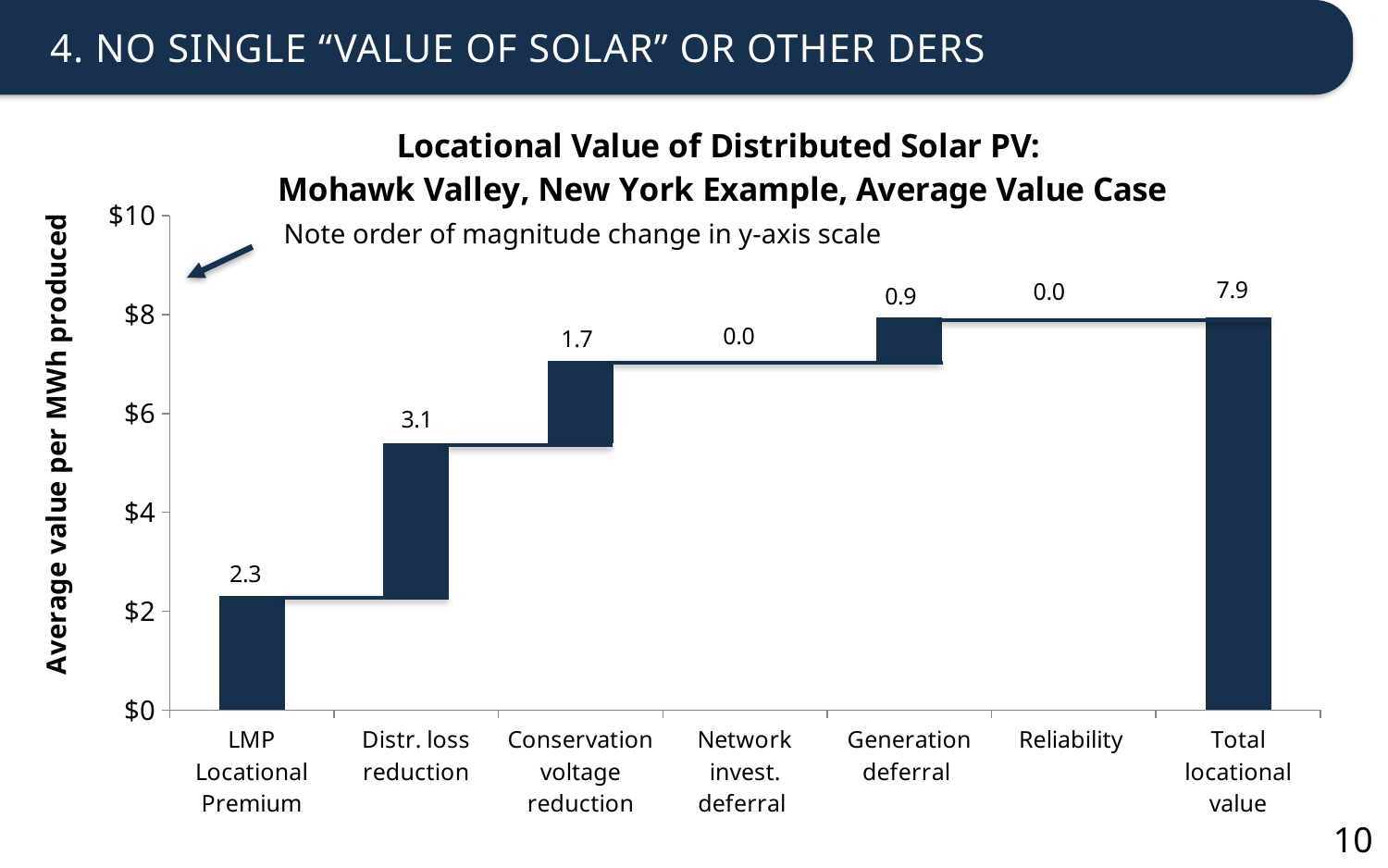
Which is larger, the value for Conservation voltage reduction or the value for Generation deferral? Conservation voltage reduction Which component category (excluding the total) has the highest value? Distr. loss reduction What is the value for Distr. loss reduction? 3.1 What is the label of the y axis? Average value per MWh produced What is the value for LMP Locational Premium? 2.3 How many categories have a value of 0.0? 2 How many categories are shown on the x axis? 7 What is the difference between the values for Distr. loss reduction and Conservation voltage reduction? 1.4 What is the value for Generation deferral? 0.9 What is the difference between the values for Distr. loss reduction and LMP Locational Premium? 0.8 What is the Total locational value shown in the chart? 7.9 Is the Total locational value greater or less than $6? greater